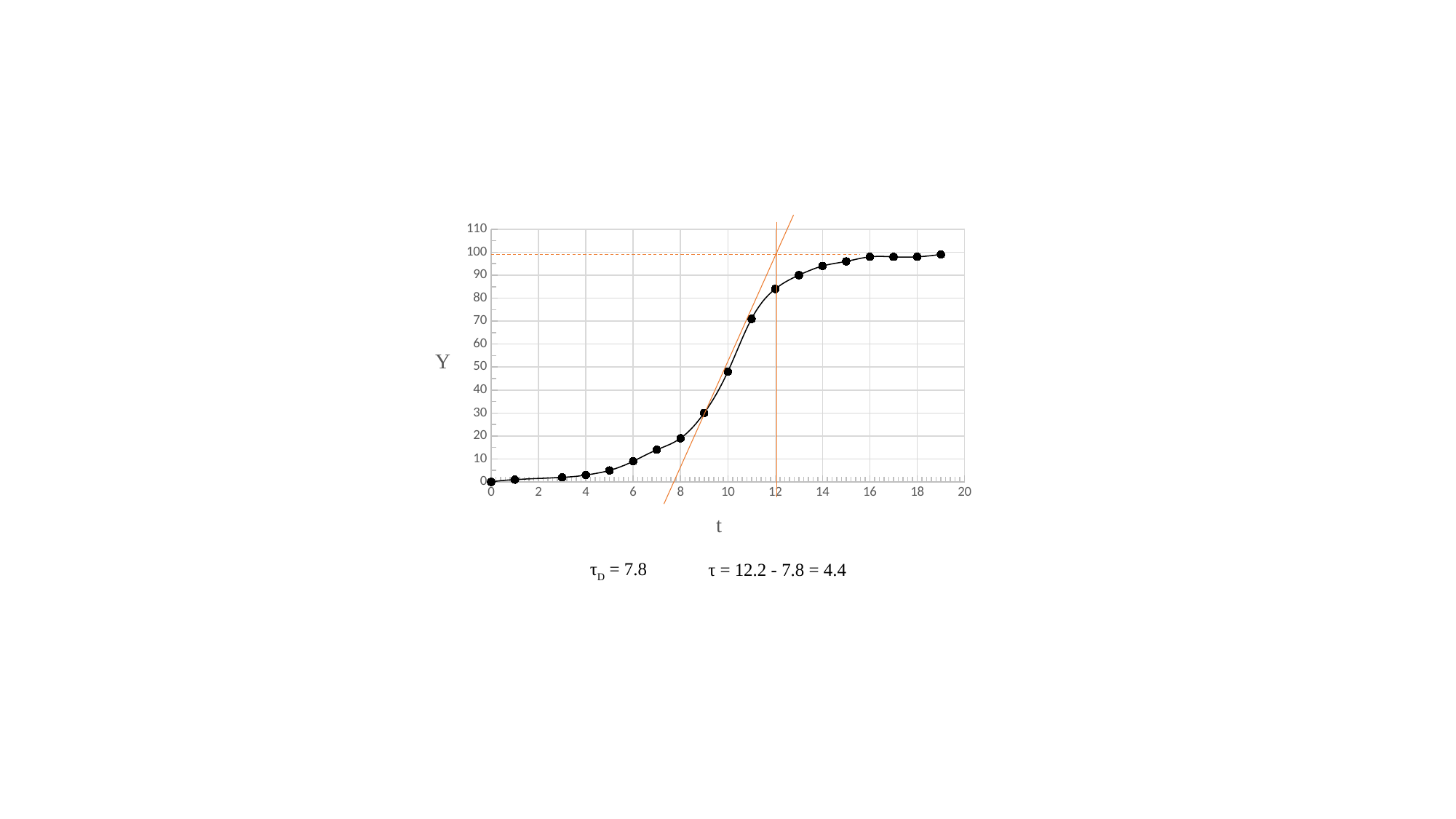
Do the Y values rise or fall as t increases along the x axis? rise Is the value of Y at t = 5 greater or less than 10? less Which has the larger Y value, t = 4 or t = 14? t = 14 Is the value of Y at t = 13 greater or less than 80? greater Is the value of Y at t = 12 greater or less than 80? greater What kind of chart is shown on the slide? line chart What value of τD is stated below the chart? 7.8 Which has the larger Y value, t = 8 or t = 12? t = 12 What is the label on the vertical axis of the chart? Y